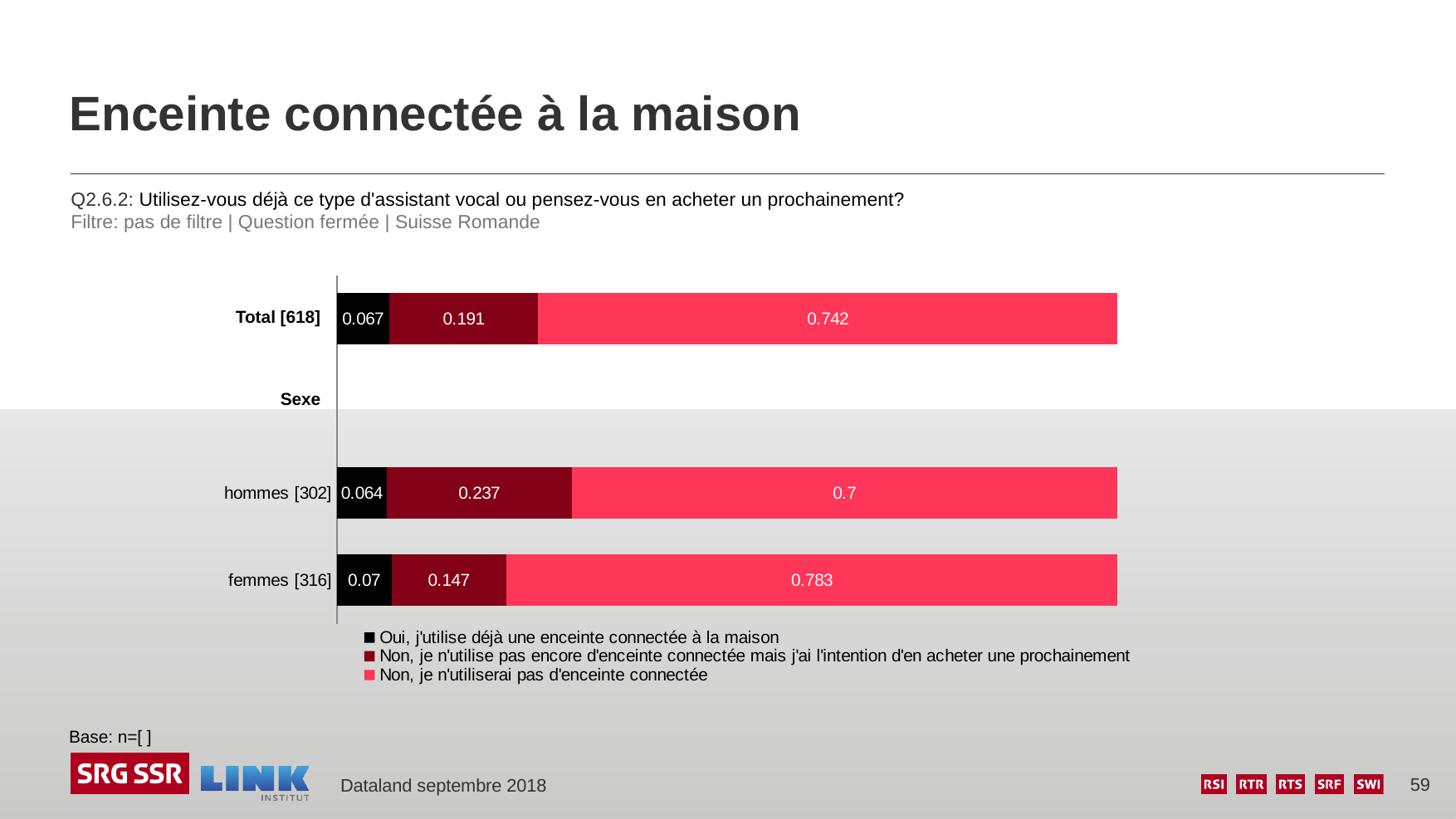
What is the value for "Oui, j'utilise déjà une enceinte connectée à la maison" for Total [618]? 0.067 Which category has the highest value for "Non, je n'utiliserai pas d'enceinte connectée"? femmes [316] What is the difference between the "Non, je n'utiliserai pas d'enceinte connectée" values for femmes [316] and hommes [302]? 0.083 Which is larger: the "Non, je n'utilise pas encore d'enceinte connectée mais j'ai l'intention d'en acheter une prochainement" value for hommes [302] or for Total [618]? hommes [302] What is the value for "Non, je n'utilise pas encore d'enceinte connectée mais j'ai l'intention d'en acheter une prochainement" for femmes [316]? 0.147 How many categories are shown in the chart? 3 Which colour represents "Oui, j'utilise déjà une enceinte connectée à la maison" in the chart? Black What kind of chart is shown on the slide? Stacked bar chart How many series does the legend list? 3 What is the total of the stacked bar for hommes [302]? 1.001 What is the value for "Non, je n'utiliserai pas d'enceinte connectée" for hommes [302]? 0.7 Which category has the lowest value for "Non, je n'utilise pas encore d'enceinte connectée mais j'ai l'intention d'en acheter une prochainement"? femmes [316]